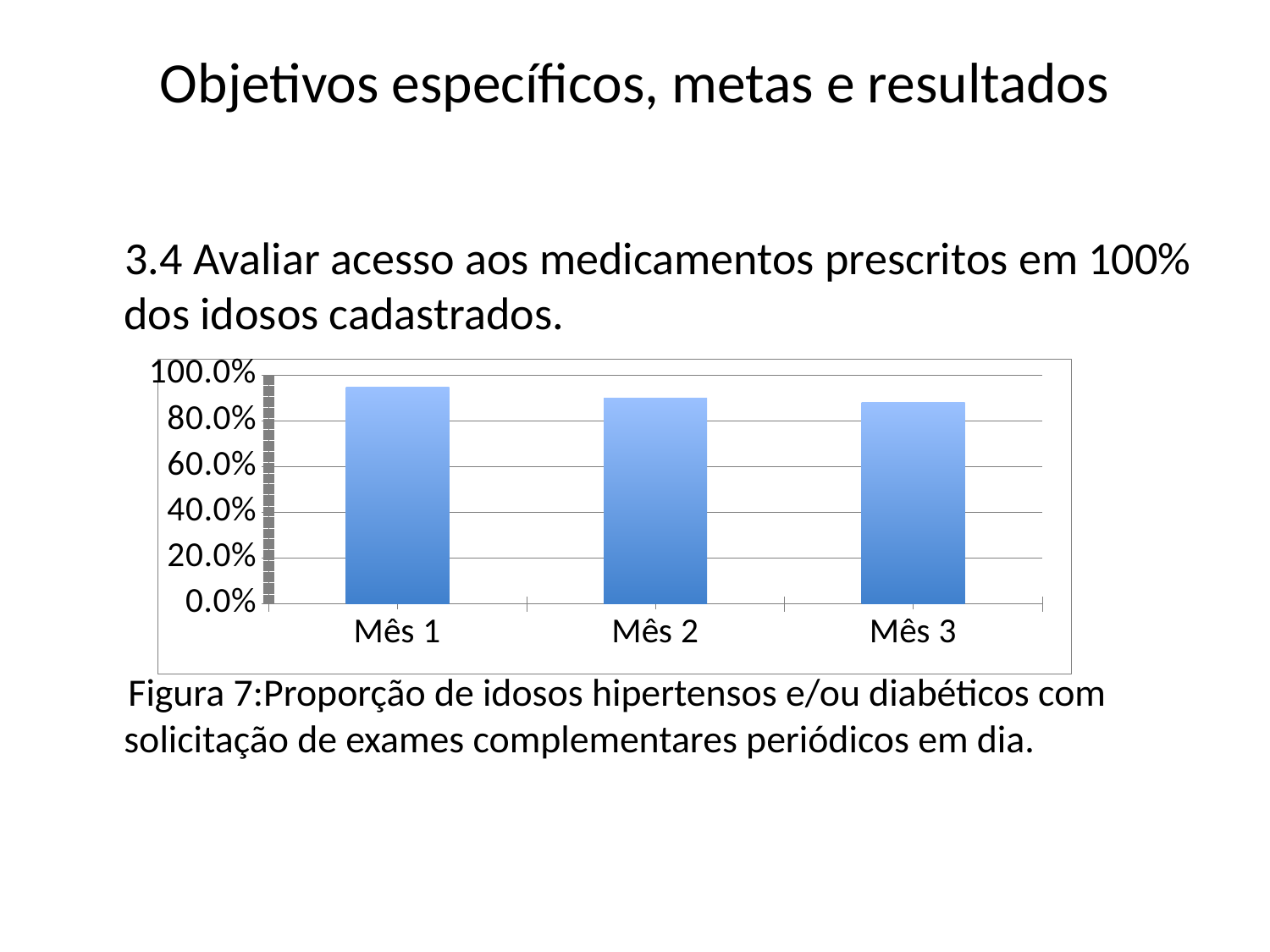
What kind of chart is shown on the slide? bar chart What is the highest value shown on the vertical axis of the chart? 100.0% What figure number is given in the caption below the chart? Figura 7 Which is larger, the value for Mês 1 or the value for Mês 3? Mês 1 Which is larger, the value for Mês 1 or the value for Mês 2? Mês 1 Do the values rise or fall from Mês 1 to Mês 3? fall Is the value for Mês 3 greater or less than 80.0%? greater Is the value for Mês 2 greater or less than 80.0%? greater How many categories (months) are plotted on the chart? 3 Is the value for Mês 1 greater or less than 100.0%? less Which month has the highest bar on the chart? Mês 1